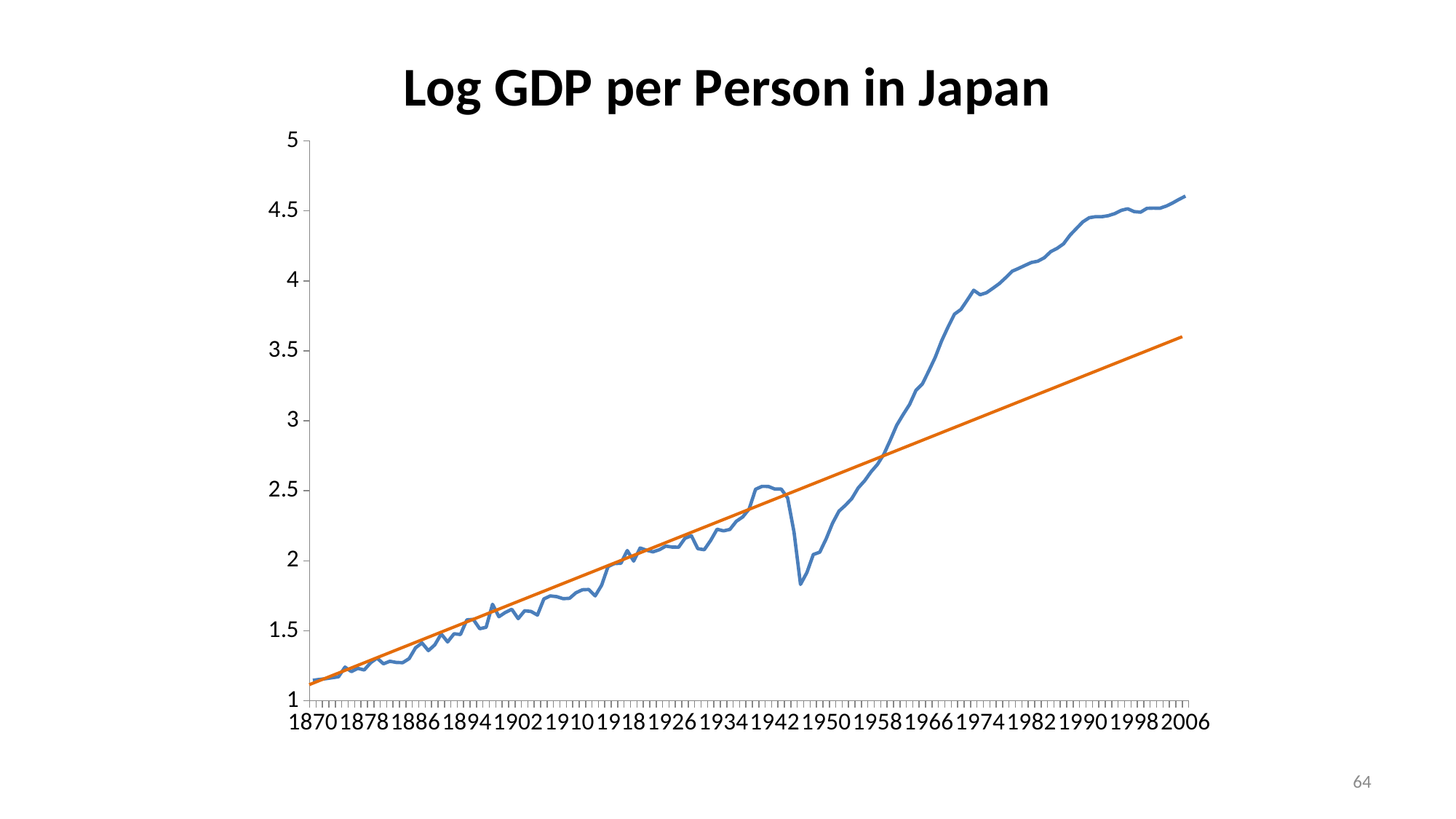
Does the blue line generally rise or fall from 1870 to 2006? Rise In 2006, which line is higher, the blue line or the orange line? The blue line Is the value of the blue line in 1870 greater or less than 1.5? less What is the title of the chart? Log GDP per Person in Japan Around 1946, which line is higher, the blue line or the orange line? The orange line What is the first year labelled on the x axis? 1870 Is the lowest point of the blue line's dip in the mid-1940s greater or less than 2? less What is the highest value shown on the y axis? 5 How many lines are plotted on the chart? 2 What kind of chart is shown on the slide? Line chart Is the value of the blue line in 2006 greater or less than 4? greater What is the last year labelled on the x axis? 2006